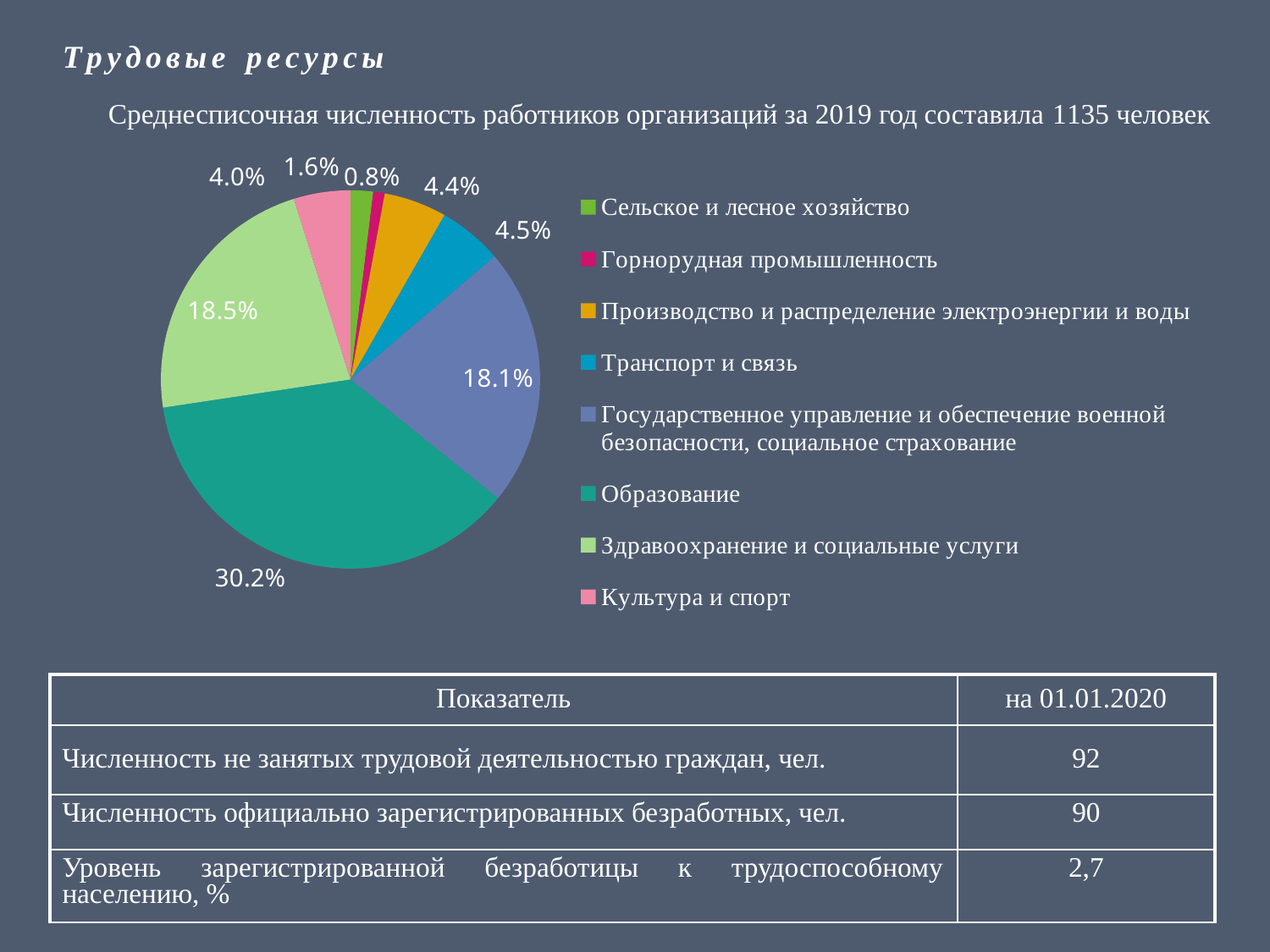
Which is larger: the share of Сельское и лесное хозяйство or the share of Горнорудная промышленность? Сельское и лесное хозяйство What share of the pie does Государственное управление и обеспечение военной безопасности, социальное страхование have? 18.1% What share of the pie does Здравоохранение и социальные услуги have? 18.5% What share of the pie does Транспорт и связь have? 4.5% What is the difference between the shares of Образование and Здравоохранение и социальные услуги? 11.7% What colour is the slice for Образование? teal Which category has the largest slice of the pie? Образование What share of the pie does Культура и спорт have? 4.0% How many slices does the pie chart have? 8 Which category has the smallest slice of the pie? Горнорудная промышленность What share of the pie does Образование have? 30.2% What kind of chart is shown on the slide? pie chart